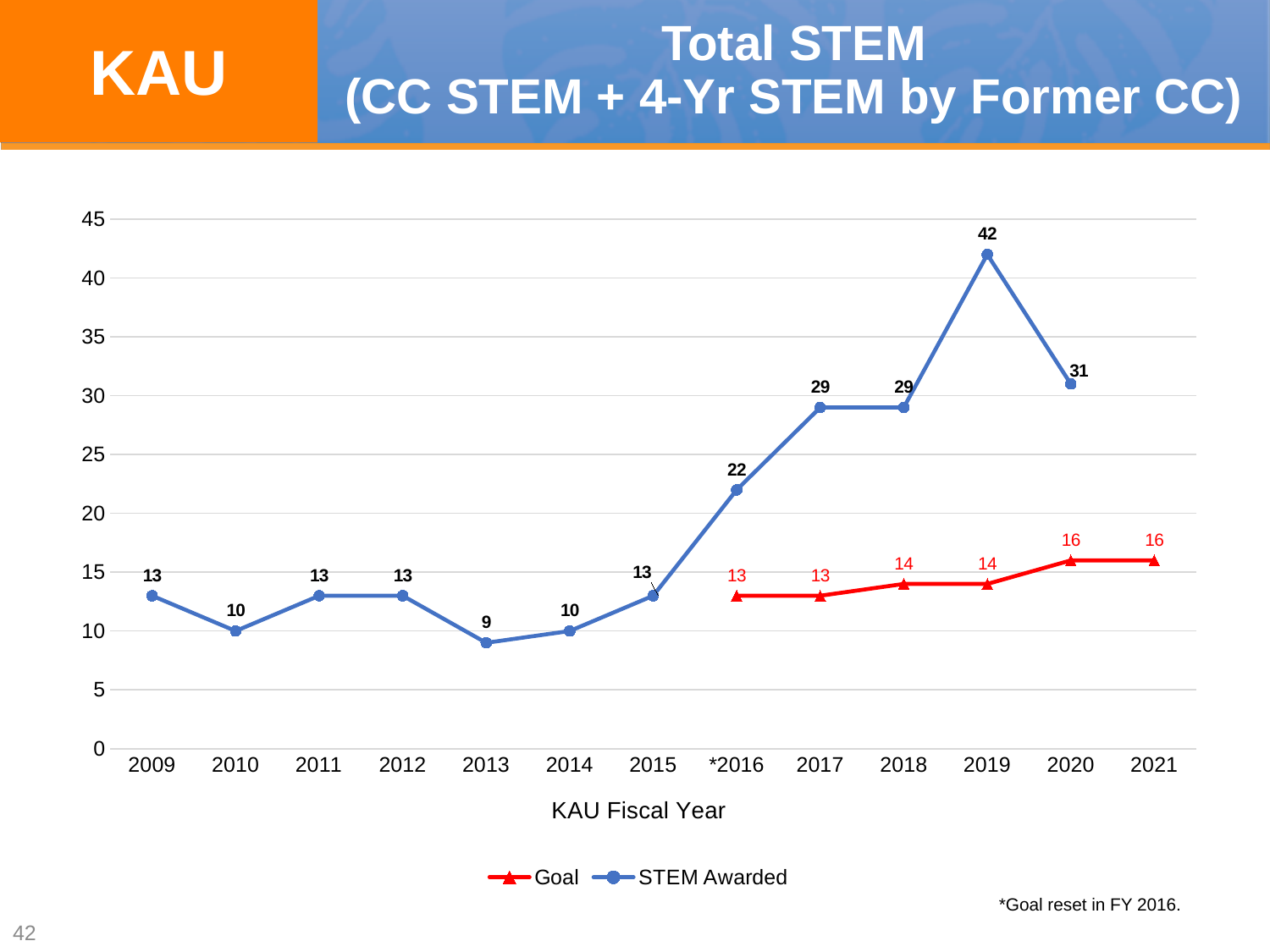
In which year is the STEM Awarded value highest? 2019 What is the STEM Awarded value for 2013? 9 Which is larger in 2020, the STEM Awarded value or the Goal value? STEM Awarded What is the label of the x axis? KAU Fiscal Year In which year is the STEM Awarded value lowest? 2013 What is the difference between the STEM Awarded value and the Goal value in 2019? 28 What is the Goal value for 2021? 16 What is the STEM Awarded value for 2019? 42 How many years are shown on the x axis? 13 How many series does the legend list? 2 What kind of chart is shown on the slide? Line chart Does the STEM Awarded value rise or fall from 2019 to 2020? Fall